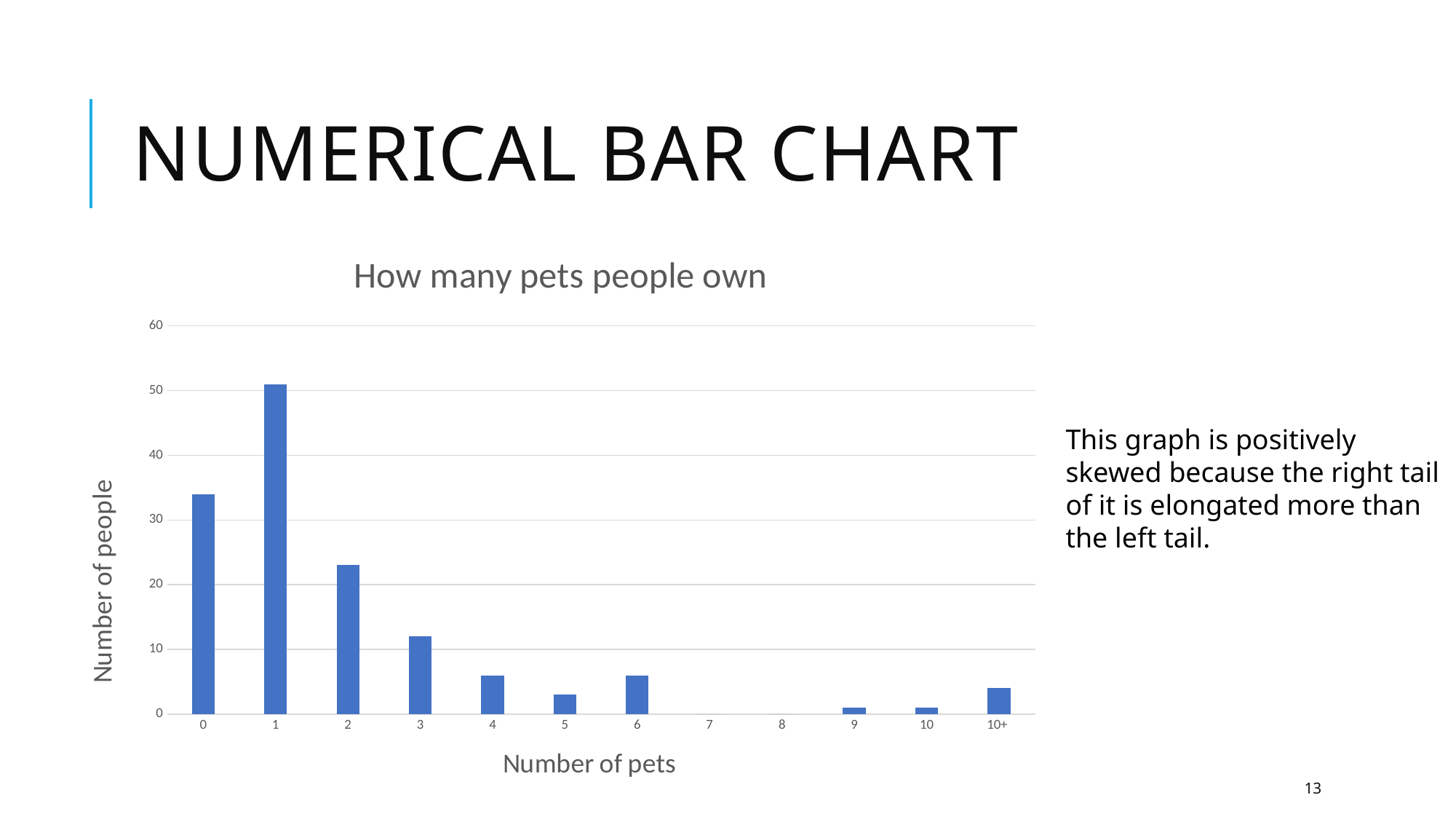
Is the value for 2 pets greater or less than 20? greater How many categories are shown along the x axis of the chart? 12 Is the value for 1 pet greater or less than 40? greater Is the value for 10+ pets greater or less than 10? less Which number of pets has the highest number of people? 1 What is the label on the vertical axis of the chart? Number of people What kind of chart is shown on the slide? bar chart Which has more people: 3 pets or 5 pets? 3 pets What is the title of the chart? How many pets people own From 1 pet to 5 pets, do the values rise or fall along the x axis? fall Which has more people: 0 pets or 2 pets? 0 pets